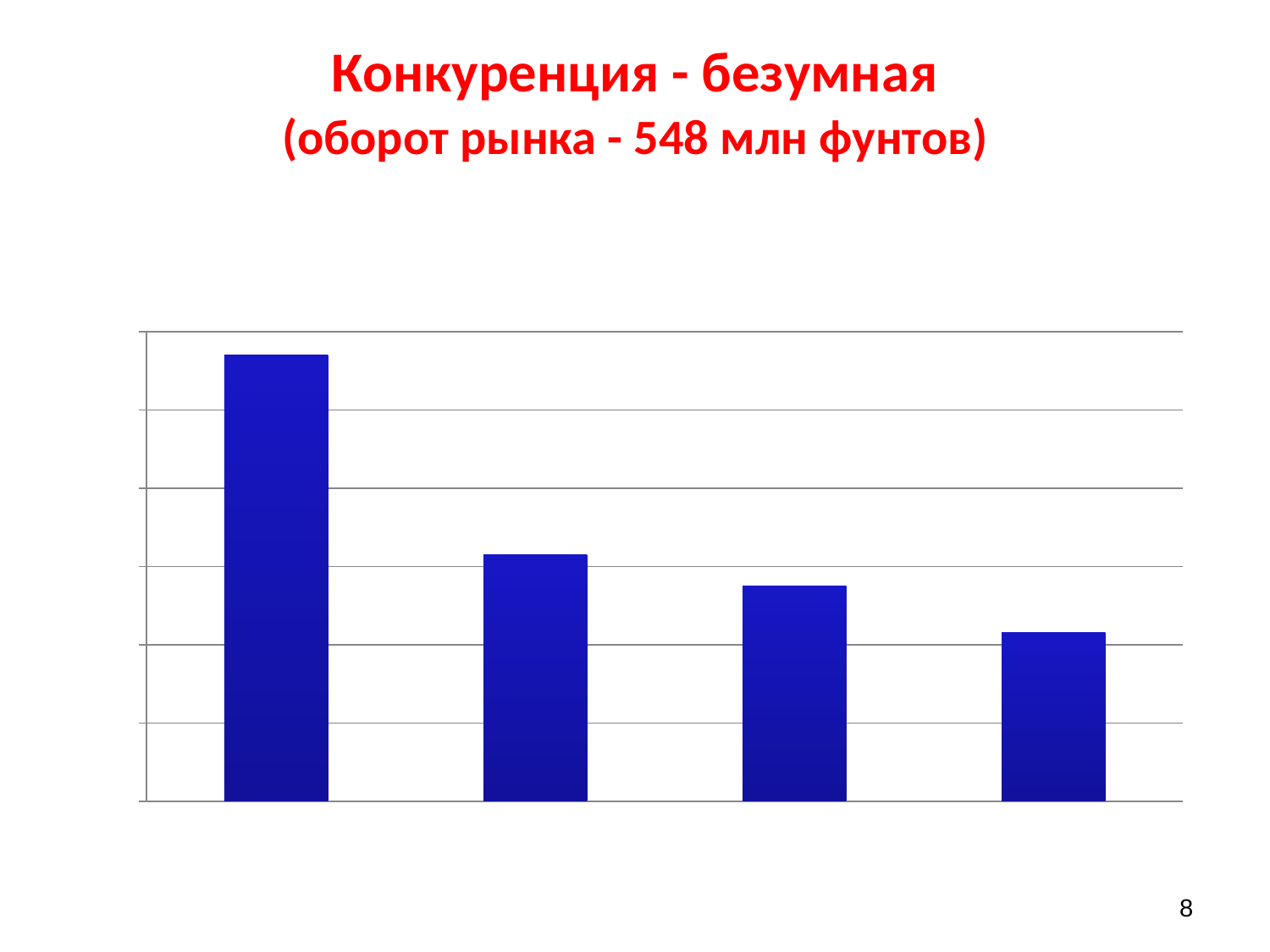
What kind of chart is shown on the slide? bar chart How many bars does the chart contain? 4 Does the chart display a legend? no Which is taller, the first bar or the fourth bar? the first bar Which is taller, the second bar or the third bar? the second bar Which bar is the shortest in the chart? the fourth (rightmost) bar What colour are the bars in the chart? blue Do the bar heights rise or fall from left to right across the chart? fall Which bar is the tallest in the chart? the first (leftmost) bar